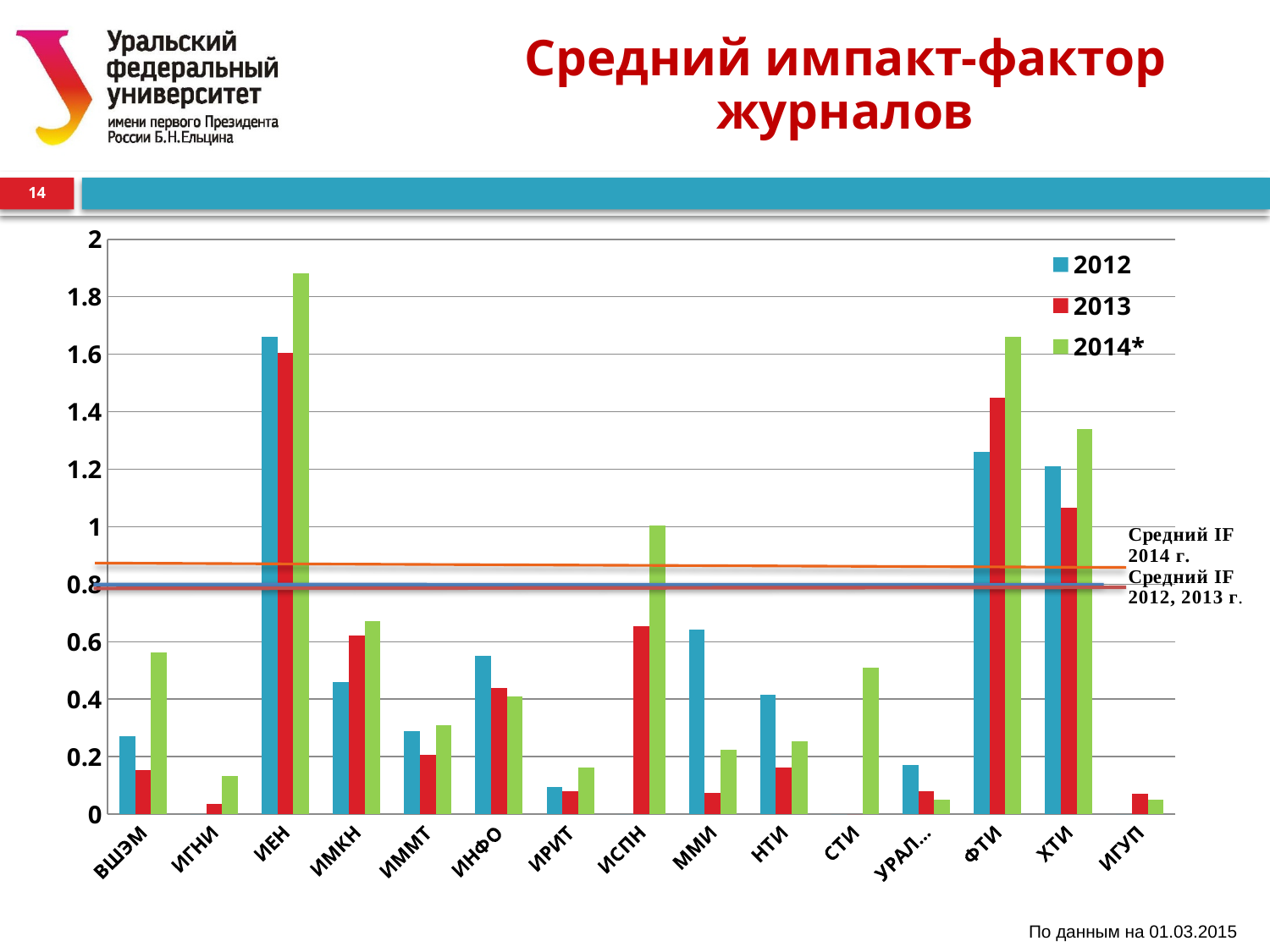
How many series does the legend list? 3 Is the 2014* value for ИЕН greater or less than 1.8? greater Which category has the highest 2013 value? ИЕН What is the title of the chart? Средний импакт-фактор журналов Is the 2013 value for ФТИ greater or less than 1.2? greater What kind of chart is shown on the slide? bar chart Which is larger, the 2013 value for ИМКН or the 2013 value for ИММТ? ИМКН How many categories are shown along the x axis? 15 Which is larger, the 2014* value for ФТИ or the 2014* value for ХТИ? ФТИ Is the 2012 value for ВШЭМ greater or less than 0.4? less Which category has the highest 2014* value? ИЕН Which category has the highest 2012 value? ИЕН